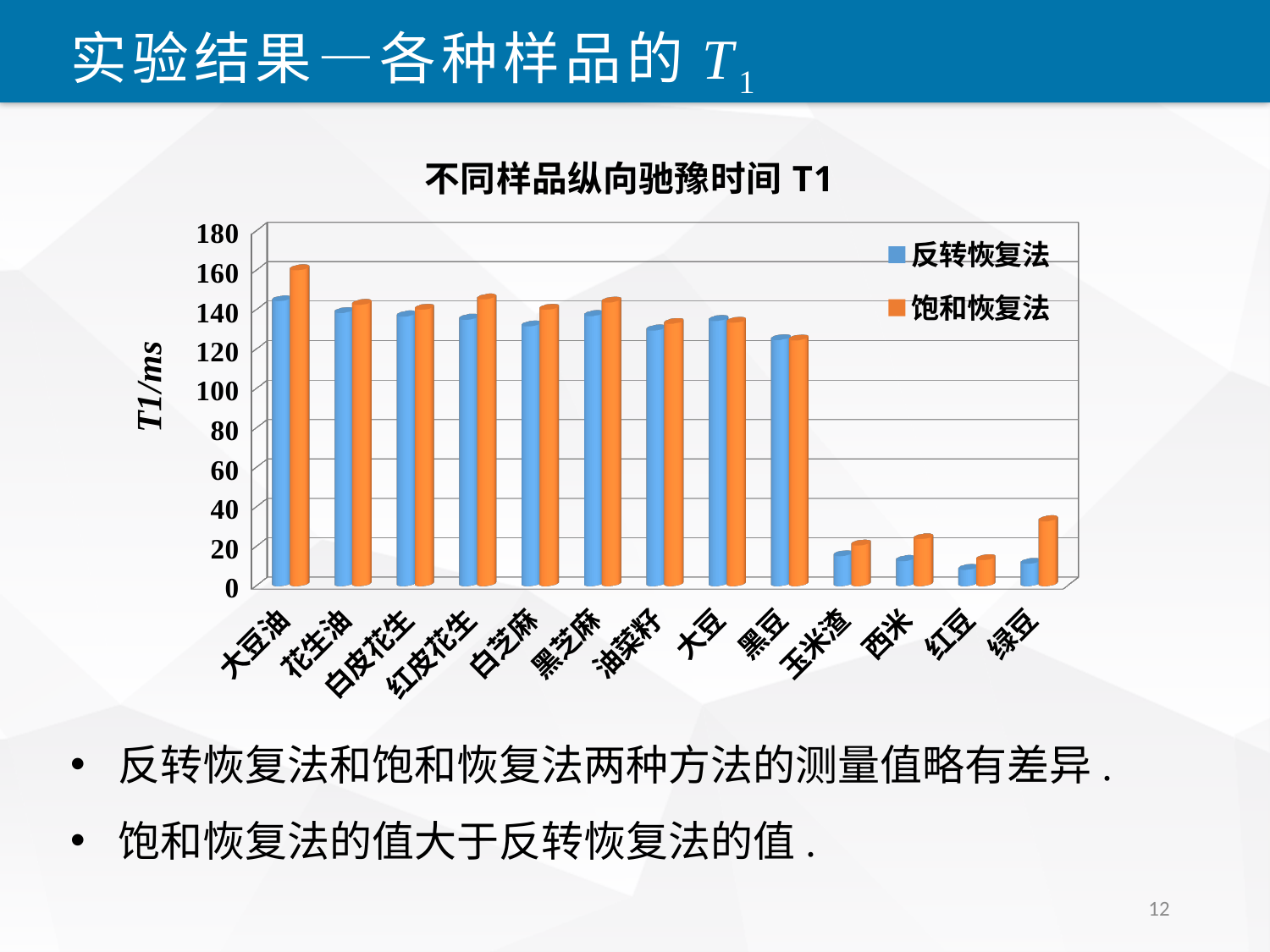
Is the 饱和恢复法 value for 绿豆 greater or less than 20? greater For 反转恢复法, which is larger: 大豆油 or 黑豆? 大豆油 What is the title of the chart? 不同样品纵向驰豫时间 T1 Is the 饱和恢复法 value for 大豆油 greater or less than 140? greater Which series is shown in orange? 饱和恢复法 Which sample has the highest 饱和恢复法 value? 大豆油 How many sample categories are shown on the x axis? 13 Do the values generally rise or fall moving from left to right along the x axis? fall How many series does the legend list? 2 What kind of chart is shown on the slide? bar chart Which sample has the lowest 饱和恢复法 value? 红豆 Is the 反转恢复法 value for 玉米渣 greater or less than 40? less